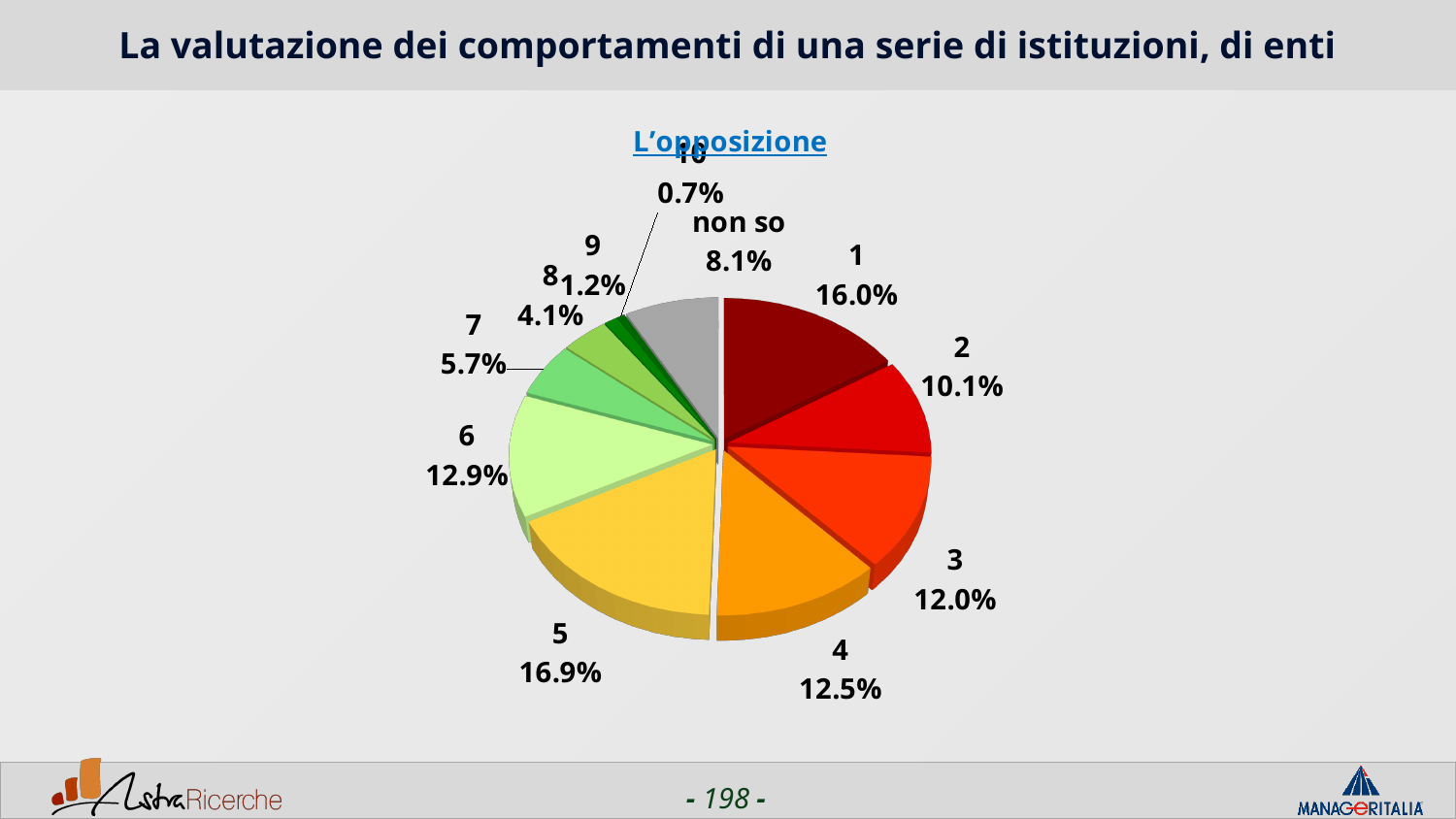
What share does category 1 have in the pie chart? 16.0% What type of chart is shown on the slide? pie chart How many slices does the pie chart have? 11 What is the value for category 7? 5.7% Which is larger, the share for category 2 or the share for category 3? 3 What is the title of the chart? L'opposizione What is the difference between the shares of category 5 and category 1? 0.9% What is the smallest percentage shown on the pie chart? 0.7% What is the difference between the values for category 6 and category 8? 8.8% What is the value shown for category 5? 16.9% Which category has the largest share of the pie? 5 What percentage is shown for 'non so'? 8.1%